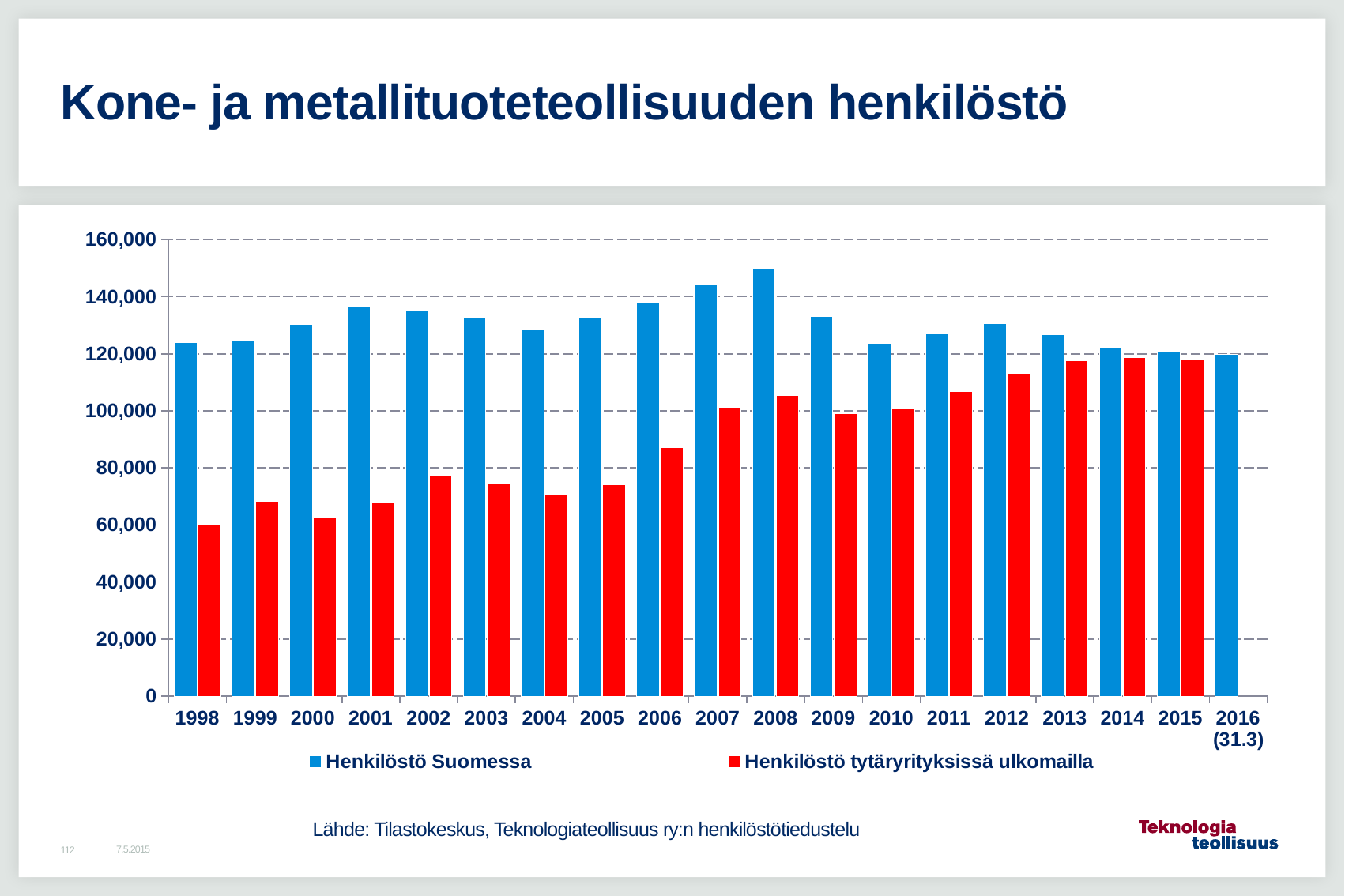
Which is larger in 2008: Henkilöstö Suomessa or Henkilöstö tytäryrityksissä ulkomailla? Henkilöstö Suomessa How many series does the legend list? 2 What kind of chart is shown on the slide? Bar chart Is the value for Henkilöstö tytäryrityksissä ulkomailla in 2012 greater or less than 100,000? greater What colour are the bars for Henkilöstö Suomessa? Blue Is the value for Henkilöstö Suomessa in 2008 greater or less than 140,000? greater Is the value for Henkilöstö Suomessa in 2016 (31.3) greater or less than 140,000? less In which year is the value for Henkilöstö Suomessa highest? 2008 How many year categories are shown on the x axis? 19 Which year has the larger value for Henkilöstö tytäryrityksissä ulkomailla: 2002 or 2006? 2006 Does the value for Henkilöstö Suomessa rise or fall from 2008 to 2016 (31.3)? fall